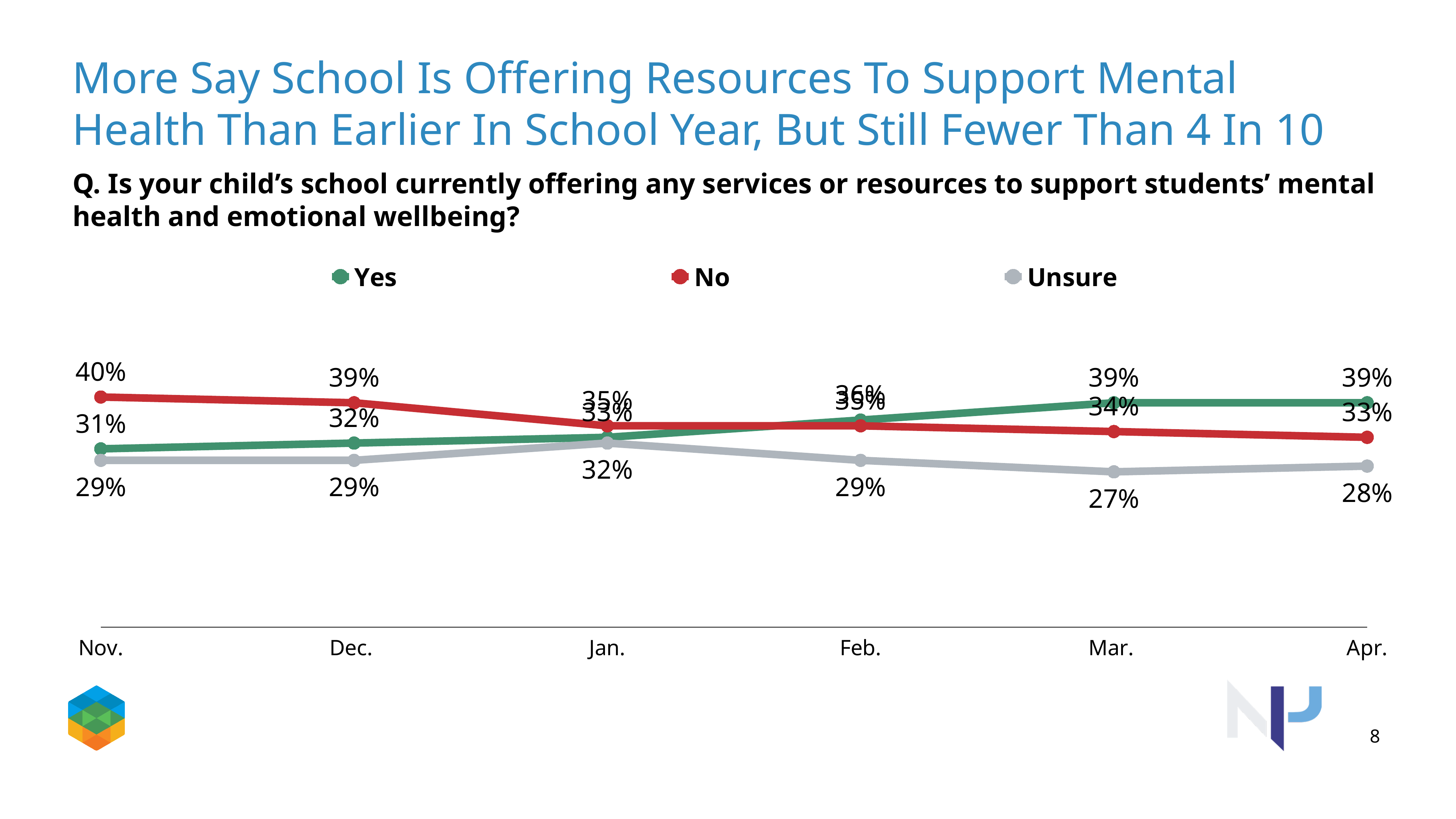
What is the value for Yes in Nov.? 31% What kind of chart is shown on the slide? line chart What is the value for Unsure in Mar.? 27% In which month is the Unsure value lowest? Mar. In which month is the Unsure value highest? Jan. Does the Yes line rise or fall from Nov. to Apr.? rise What is the value for No in Nov.? 40% How many series does the legend list? 3 In Apr., which is larger, Yes or No? Yes What is the value for Yes in Apr.? 39% How many months are plotted along the x axis? 6 By how many percentage points did the No value fall from Nov. to Apr.? 7